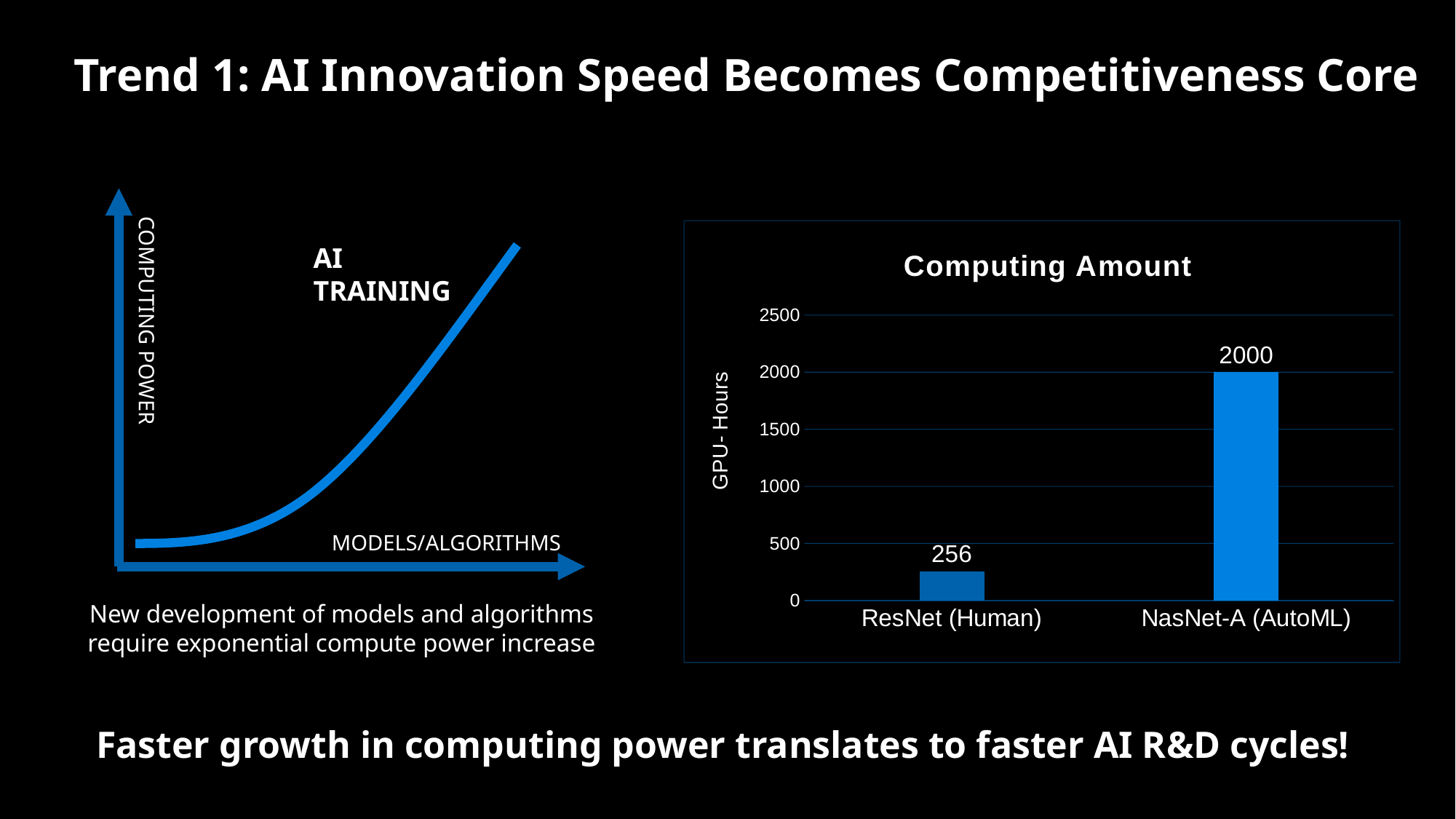
In the "Computing Amount" chart, what is the difference between the NasNet-A (AutoML) and ResNet (Human) values? 1744 In the "Computing Amount" chart, is the value for ResNet (Human) greater or less than 500? less In the "Computing Amount" chart, which category has the lowest value? ResNet (Human) What kind of chart is the "Computing Amount" chart? bar chart In the "Computing Amount" chart, which category has the highest value? NasNet-A (AutoML) In the "Computing Amount" chart, what is the value for ResNet (Human)? 256 In the "Computing Amount" chart, what is the highest value shown on the y-axis? 2500 In the "Computing Amount" chart, what is the value for NasNet-A (AutoML)? 2000 In the "Computing Amount" chart, is the value for NasNet-A (AutoML) greater or less than 1500? greater How many categories are shown in the "Computing Amount" chart? 2 In the "Computing Amount" chart, which is larger: the value for ResNet (Human) or NasNet-A (AutoML)? NasNet-A (AutoML) What is the y-axis label of the "Computing Amount" chart? GPU- Hours